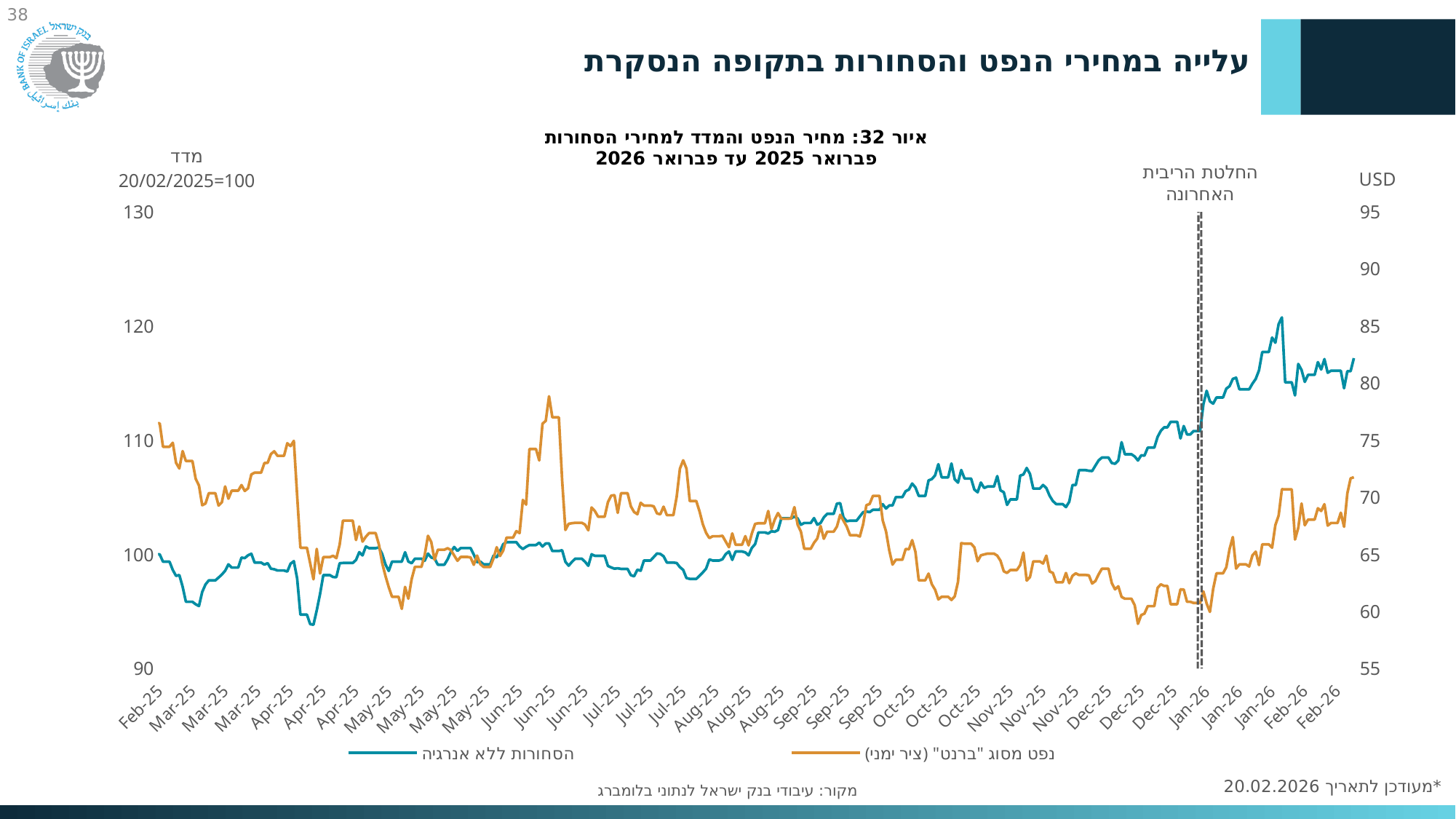
Is the value of נפט מסוג "ברנט" at the start of the series (Feb-25) greater or less than 70 USD? greater What is the unit shown on the right-hand axis? USD Does the נפט מסוג "ברנט" series rise or fall between Feb-25 and Apr-25? fall How many series does the legend list? 2 Is the value of נפט מסוג "ברנט" at the end of the series (Feb-26) greater or less than 65 USD? greater Does the הסחורות ללא אנרגיה series end higher or lower in Feb-26 than it started in Feb-25? higher Is the value of הסחורות ללא אנרגיה at the end of the series (Feb-26) greater or less than 110? greater Does the הסחורות ללא אנרגיה series rise or fall between Oct-25 and Feb-26? rise What kind of chart is shown on the slide? Line chart Which series is plotted on the right axis (ציר ימני)? נפט מסוג "ברנט"